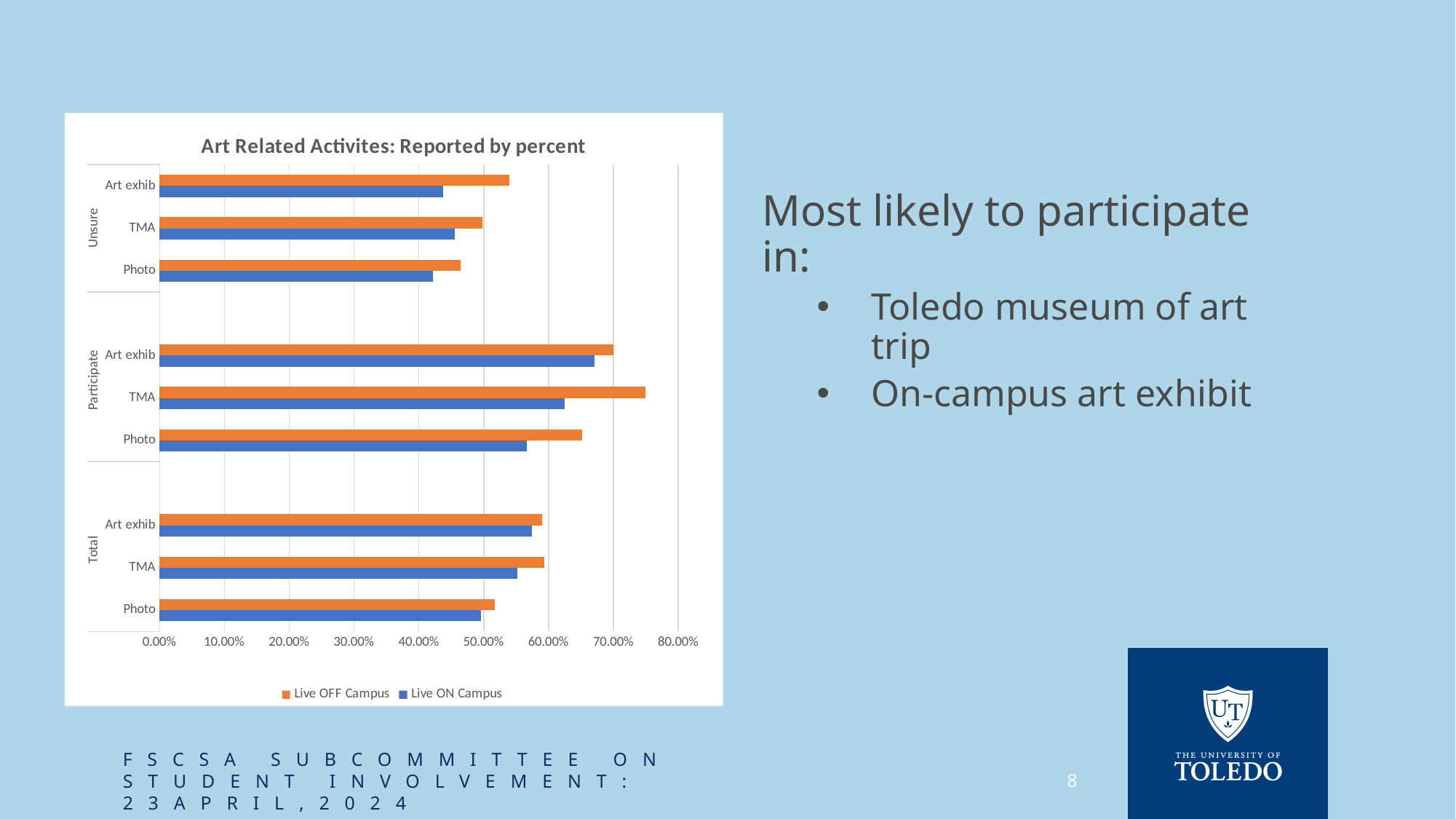
Within the Unsure group, which activity has the highest Live OFF Campus value? Art exhib Is the Live ON Campus value for Art exhib in the Unsure group greater or less than 50.00%? less How many series does the chart legend list? 2 What are the two series named in the chart legend? Live OFF Campus and Live ON Campus Is the Live OFF Campus value for Photo in the Participate group greater or less than 60.00%? greater How many category bars pairs (activity rows) are plotted in the chart across all three groups? 9 What kind of chart is shown on the slide? Bar chart Which activity and group has the highest Live OFF Campus value in the chart? TMA in the Participate group What is the title of the chart? Art Related Activites: Reported by percent Within the Participate group, which activity has the lowest Live ON Campus value? Photo Is the Live OFF Campus value for TMA in the Participate group greater or less than 70.00%? greater For TMA in the Participate group, which is larger: the Live OFF Campus value or the Live ON Campus value? Live OFF Campus